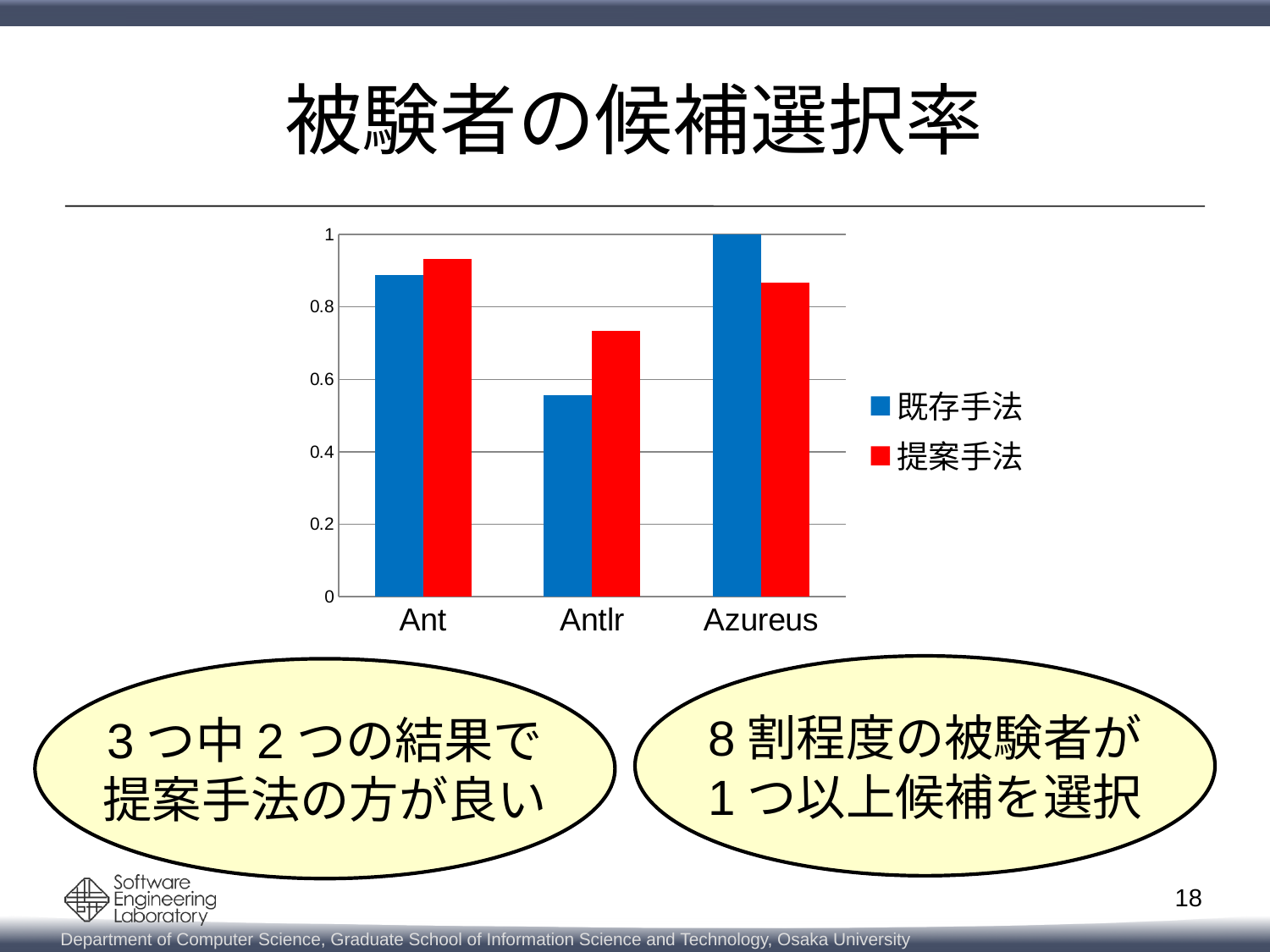
How many series does the chart's legend list? 2 How many categories are shown on the x axis of the chart? 3 What is the value of 既存手法 for Azureus? 1 Is the value of 提案手法 for Antlr greater or less than 0.6? greater Is the value of 既存手法 for Antlr greater or less than 0.6? less Which category has the lowest value for 既存手法? Antlr What is the title of the slide containing the chart? 被験者の候補選択率 For Antlr, which series has the larger value, 既存手法 or 提案手法? 提案手法 For Azureus, which series has the larger value, 既存手法 or 提案手法? 既存手法 Is the value of 既存手法 for Ant greater or less than 0.8? greater What kind of chart is shown on the slide? bar chart